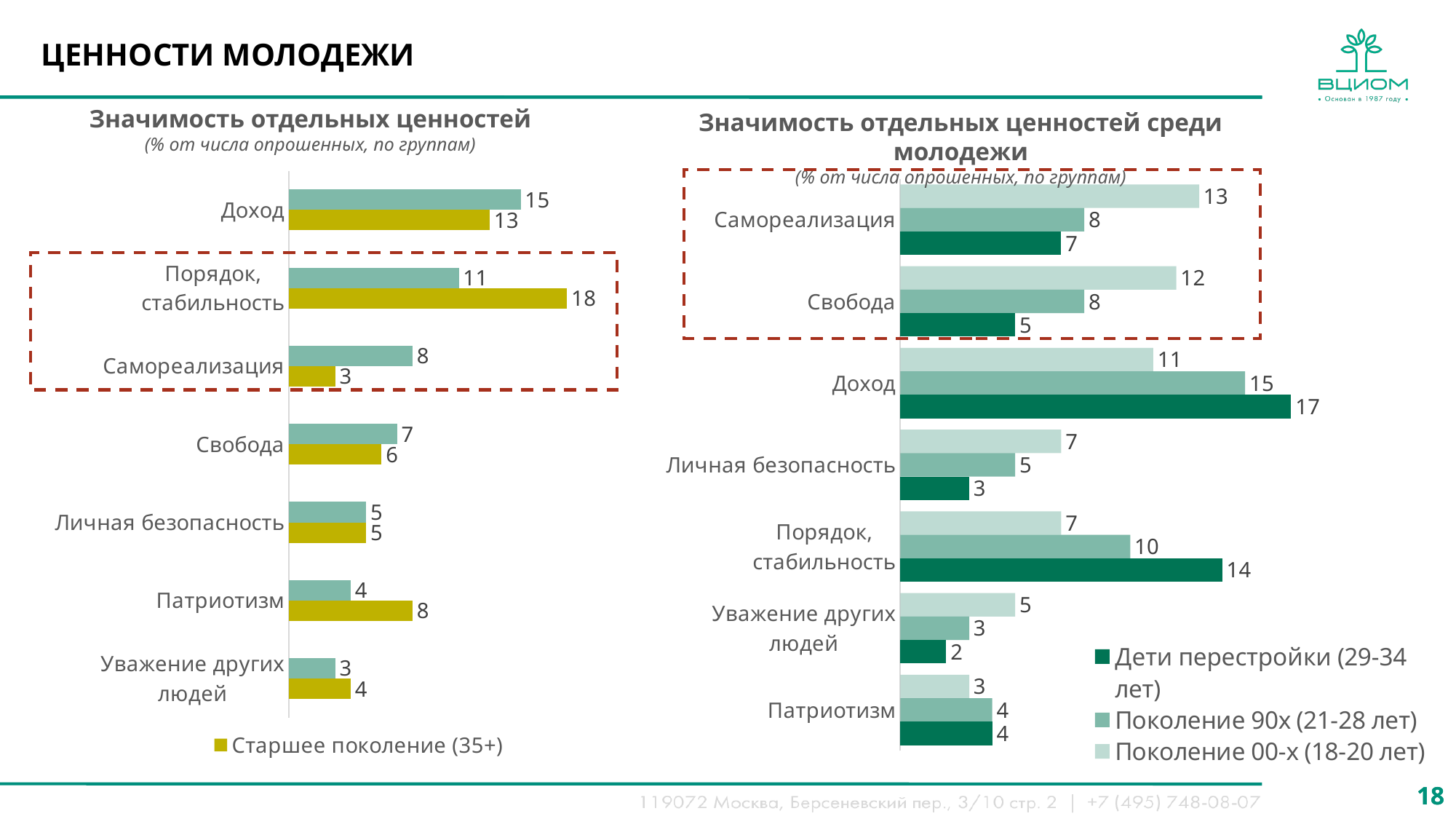
In the right chart 'Значимость отдельных ценностей среди молодежи', which category has the lowest value for Дети перестройки (29-34 лет)? Уважение других людей In the right chart 'Значимость отдельных ценностей среди молодежи', what is the value for Доход for Дети перестройки (29-34 лет)? 17 In the right chart 'Значимость отдельных ценностей среди молодежи', which is larger for Свобода: Поколение 00-х (18-20 лет) or Дети перестройки (29-34 лет)? Поколение 00-х (18-20 лет) In the left chart 'Значимость отдельных ценностей', what is the value for Порядок, стабильность for Старшее поколение (35+)? 18 In the left chart 'Значимость отдельных ценностей', what is the value for Самореализация for Старшее поколение (35+)? 3 In the right chart 'Значимость отдельных ценностей среди молодежи', what is the difference between Дети перестройки (29-34 лет) and Поколение 00-х (18-20 лет) for Порядок, стабильность? 7 In the left chart 'Значимость отдельных ценностей', what is the difference between the Старшее поколение (35+) values for Доход and Патриотизм? 5 In the right chart 'Значимость отдельных ценностей среди молодежи', what is the value for Самореализация for Поколение 00-х (18-20 лет)? 13 In the left chart 'Значимость отдельных ценностей', which category has the highest value for Старшее поколение (35+)? Порядок, стабильность How many series does the legend of the right chart 'Значимость отдельных ценностей среди молодежи' list? 3 What type of chart is the right chart 'Значимость отдельных ценностей среди молодежи'? Bar chart In the left chart 'Значимость отдельных ценностей', how many categories are shown? 7